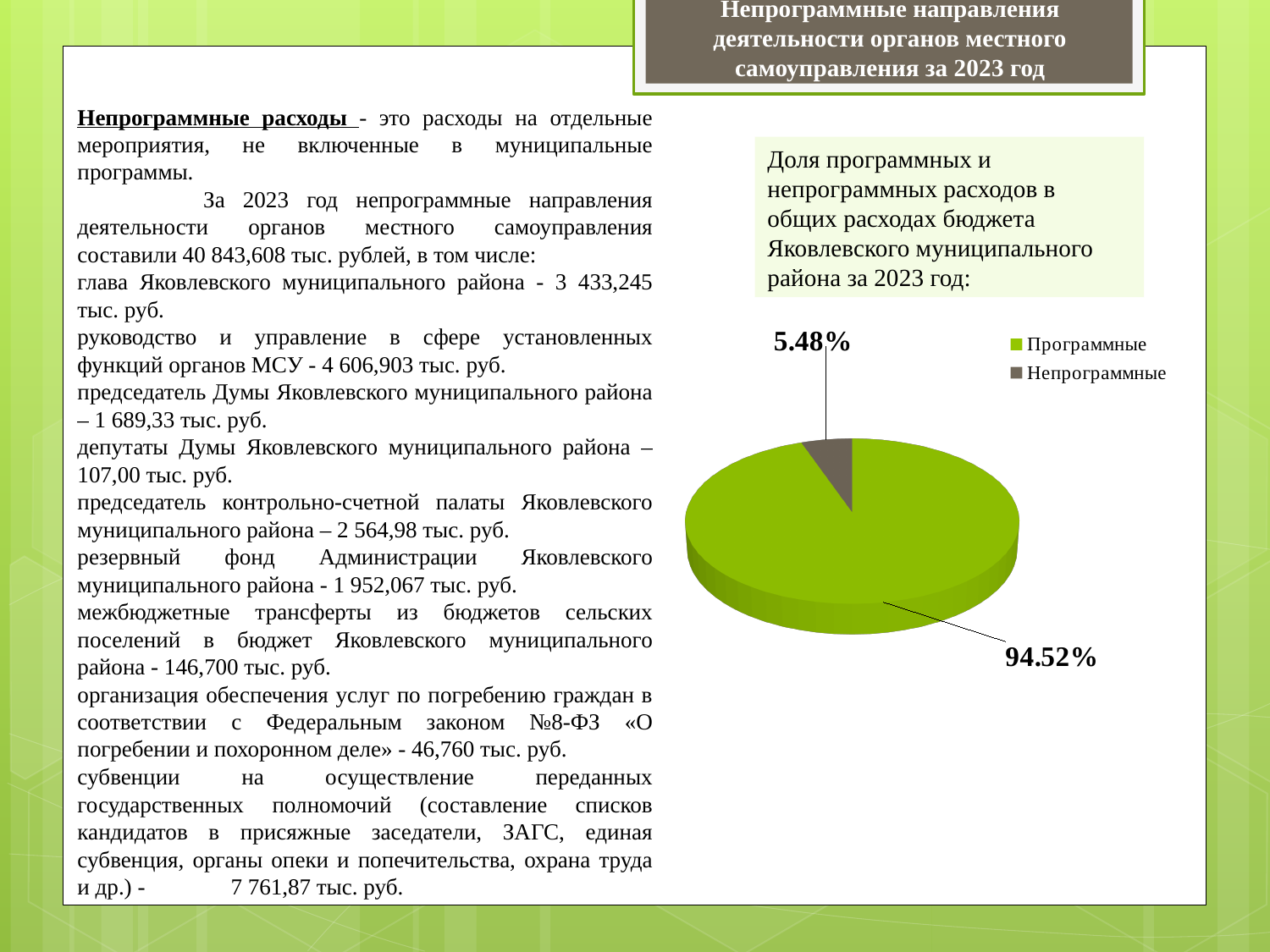
How many slices does the pie chart have? 2 How many entries does the legend of the pie chart list? 2 What share of the pie does the Программные slice represent? 94.52% What is the difference in percentage points between the Программные and Непрограммные slices? 89.04 What kind of chart is shown on the slide? pie chart Is the share of Непрограммные greater or less than 10%? less Which slice of the pie chart is the largest? Программные Which slice of the pie chart is the smallest? Непрограммные Which is larger in the pie chart, Программные or Непрограммные? Программные What colour is the Непрограммные slice in the pie chart? grey-brown What share of the pie does the Непрограммные slice represent? 5.48% What colour is the Программные slice in the pie chart? green